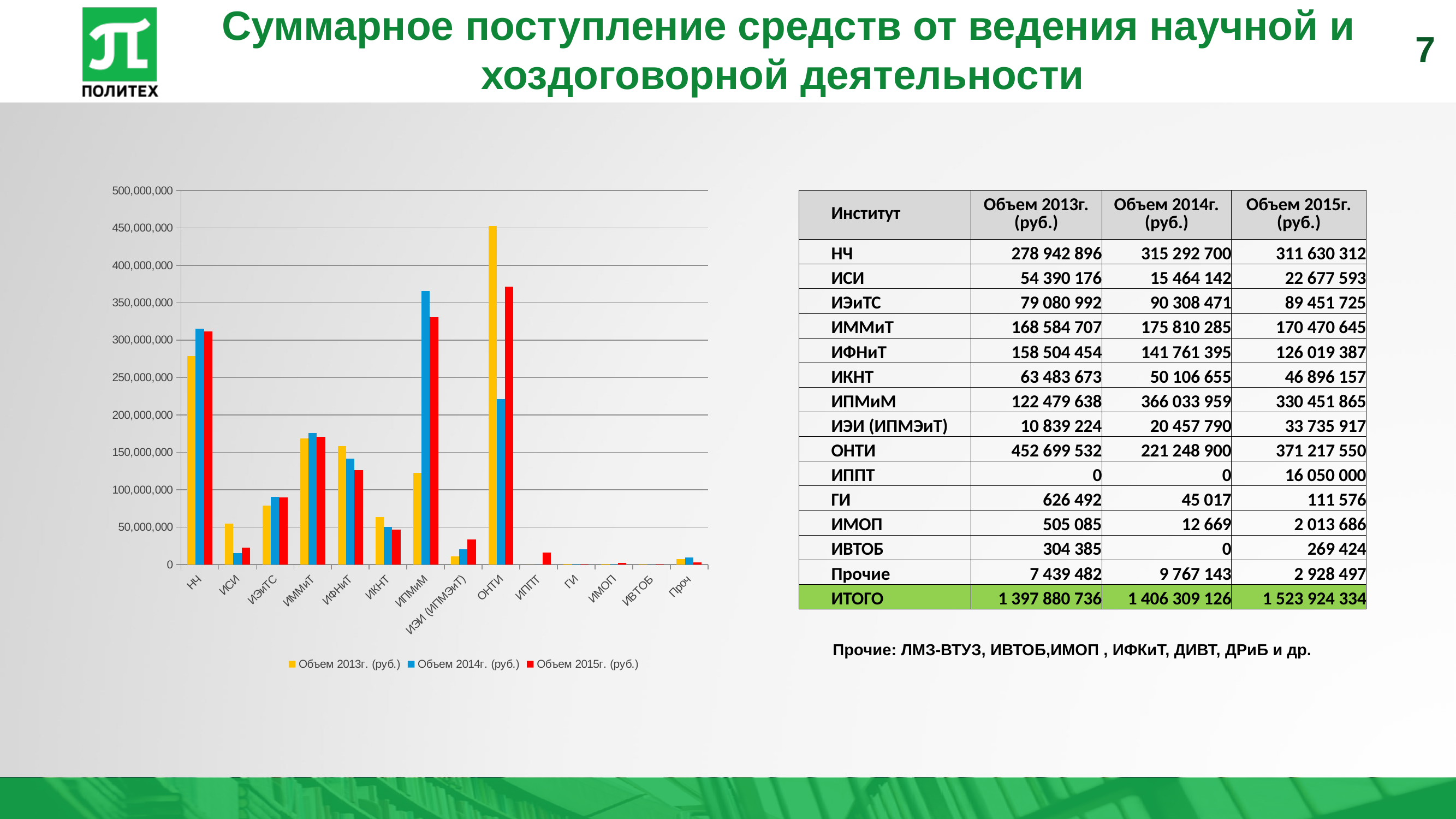
How many institute categories are plotted along the x axis of the chart? 14 For ИПМиМ, which is larger: Объем 2013г. (руб.) or Объем 2014г. (руб.)? Объем 2014г. (руб.) What colour represents the series Объем 2015г. (руб.) in the chart? red What is the difference between Объем 2013г. (руб.) and Объем 2014г. (руб.) for ИСИ? 38 926 034 Do the values for ИФНиТ rise or fall from 2013 to 2015? fall What is the value of Объем 2015г. (руб.) for ИППТ? 16 050 000 Which institute has the highest value for Объем 2014г. (руб.)? ИПМиМ Which institute has the highest value for Объем 2013г. (руб.)? ОНТИ What kind of chart is shown on the slide? bar chart How many series does the chart legend list? 3 What is the value of Объем 2014г. (руб.) for НЧ? 315 292 700 Is the value of Объем 2013г. (руб.) for ОНТИ greater or less than 400,000,000? greater